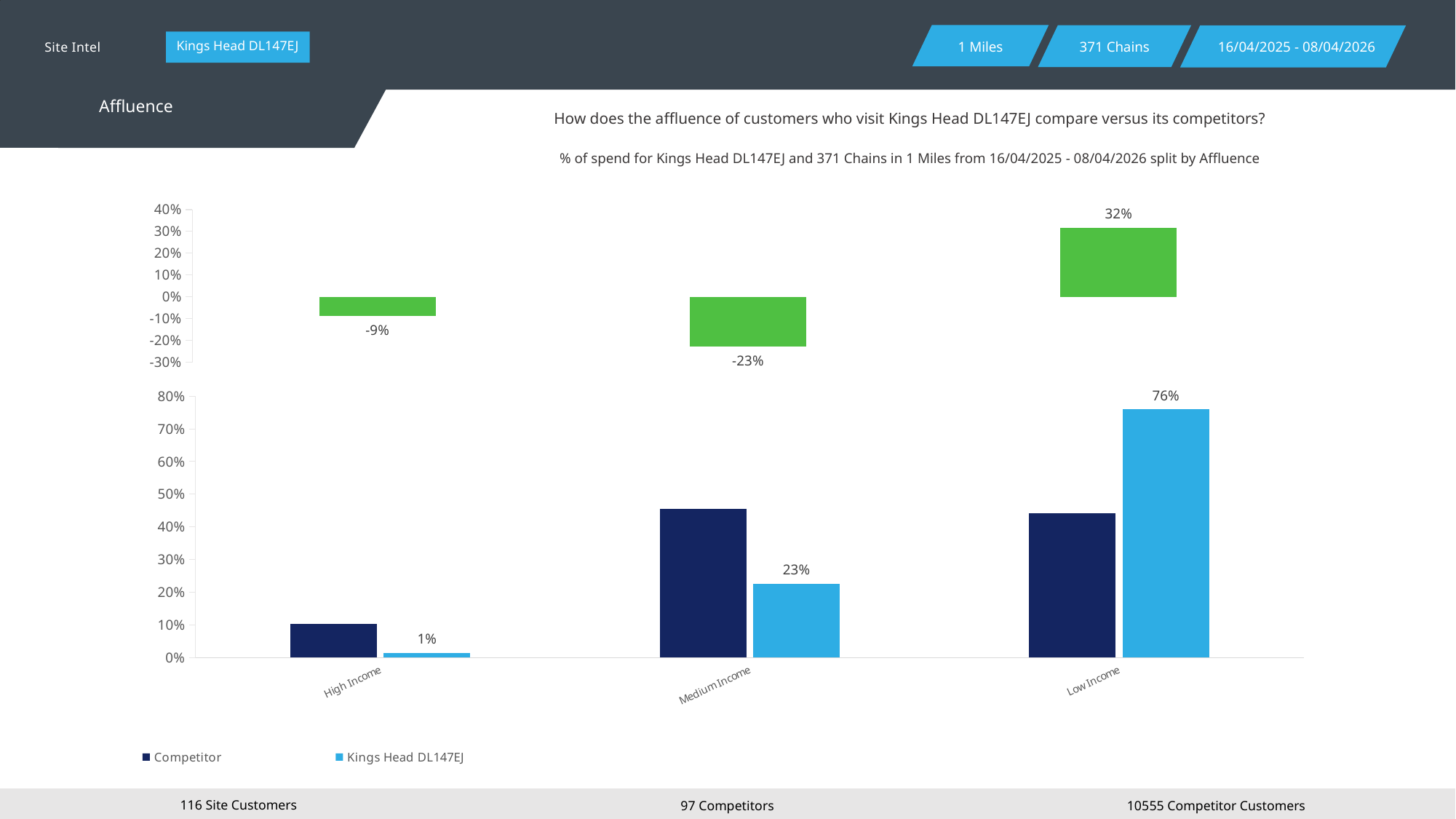
In the bottom chart, which is larger for Low Income: the Competitor value or the Kings Head DL147EJ value? Kings Head DL147EJ In the bottom chart, is the Competitor value for High Income greater or less than 20%? less How many categories are shown on the x axis of the bottom chart? 3 In the bottom chart, what is the difference between the Kings Head DL147EJ values for Low Income and Medium Income? 53% How many series does the legend of the bottom chart list? 2 In the bottom chart, what is the value for Kings Head DL147EJ in the High Income category? 1% In the bottom chart, is the Competitor value for Medium Income greater or less than 40%? greater In the bottom chart, what is the value for Kings Head DL147EJ in the Low Income category? 76% In the top chart, which category has the lowest value? Medium Income In the top chart, what is the value shown for Medium Income? -23% What kind of chart is the bottom chart? Bar chart